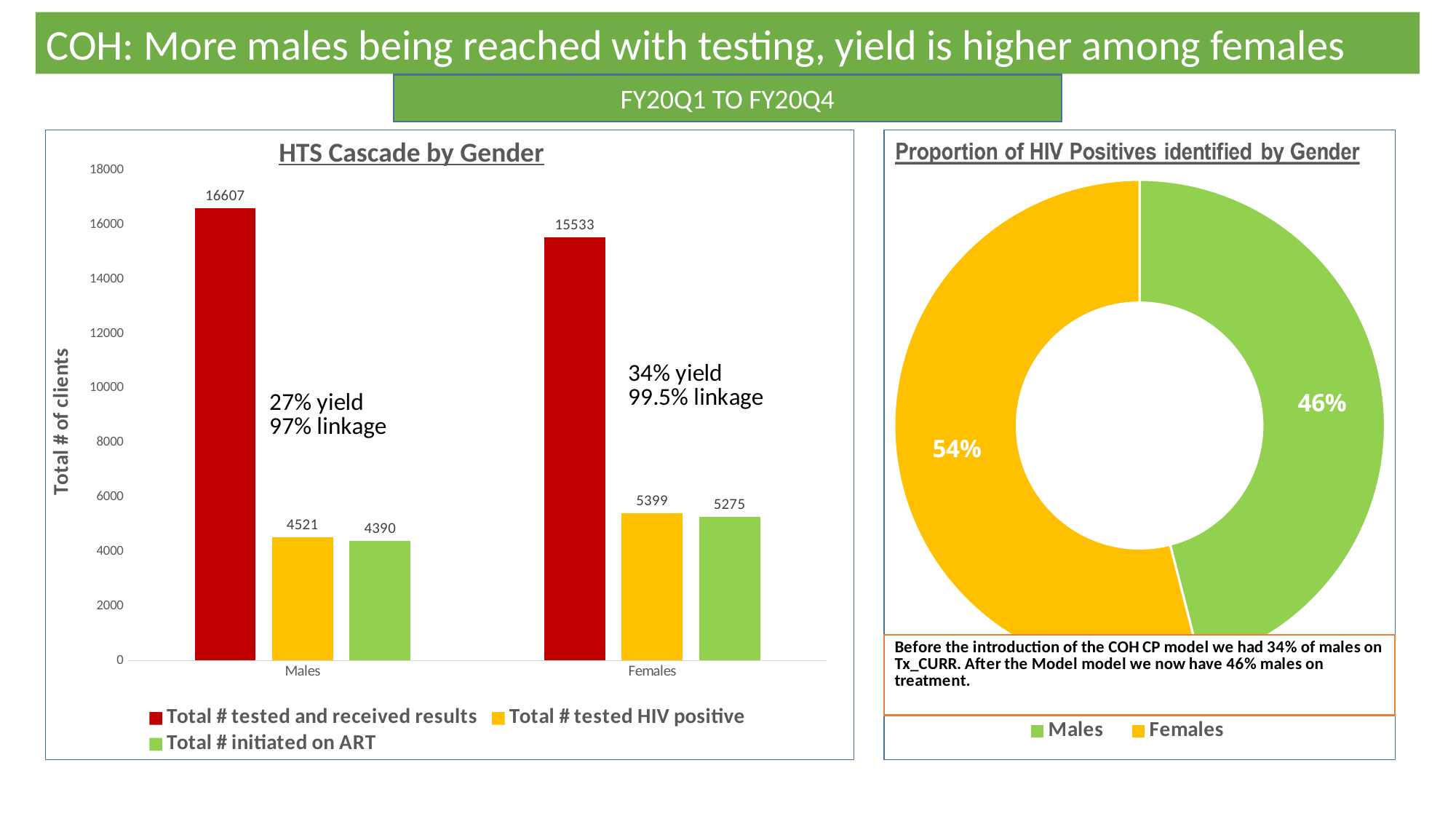
What kind of chart is the Proportion of HIV Positives identified by Gender chart? doughnut chart How many series does the legend of the HTS Cascade by Gender chart list? 3 In the HTS Cascade by Gender chart, what is the difference between Total # tested and received results for Males and for Females? 1074 What is the y-axis title of the HTS Cascade by Gender chart? Total # of clients In the HTS Cascade by Gender chart, what is the value of Total # tested HIV positive for Females? 5399 In the Proportion of HIV Positives identified by Gender chart, what share is Females? 54% In the HTS Cascade by Gender chart, what is the value of Total # initiated on ART for Males? 4390 In the HTS Cascade by Gender chart, which gender has the higher value for Total # tested HIV positive? Females In the Proportion of HIV Positives identified by Gender chart, which gender has the larger share? Females In the HTS Cascade by Gender chart, what is the value of Total # tested and received results for Males? 16607 In the HTS Cascade by Gender chart, is the value of Total # initiated on ART for Females greater or less than 6000? less What kind of chart is the HTS Cascade by Gender chart? bar chart